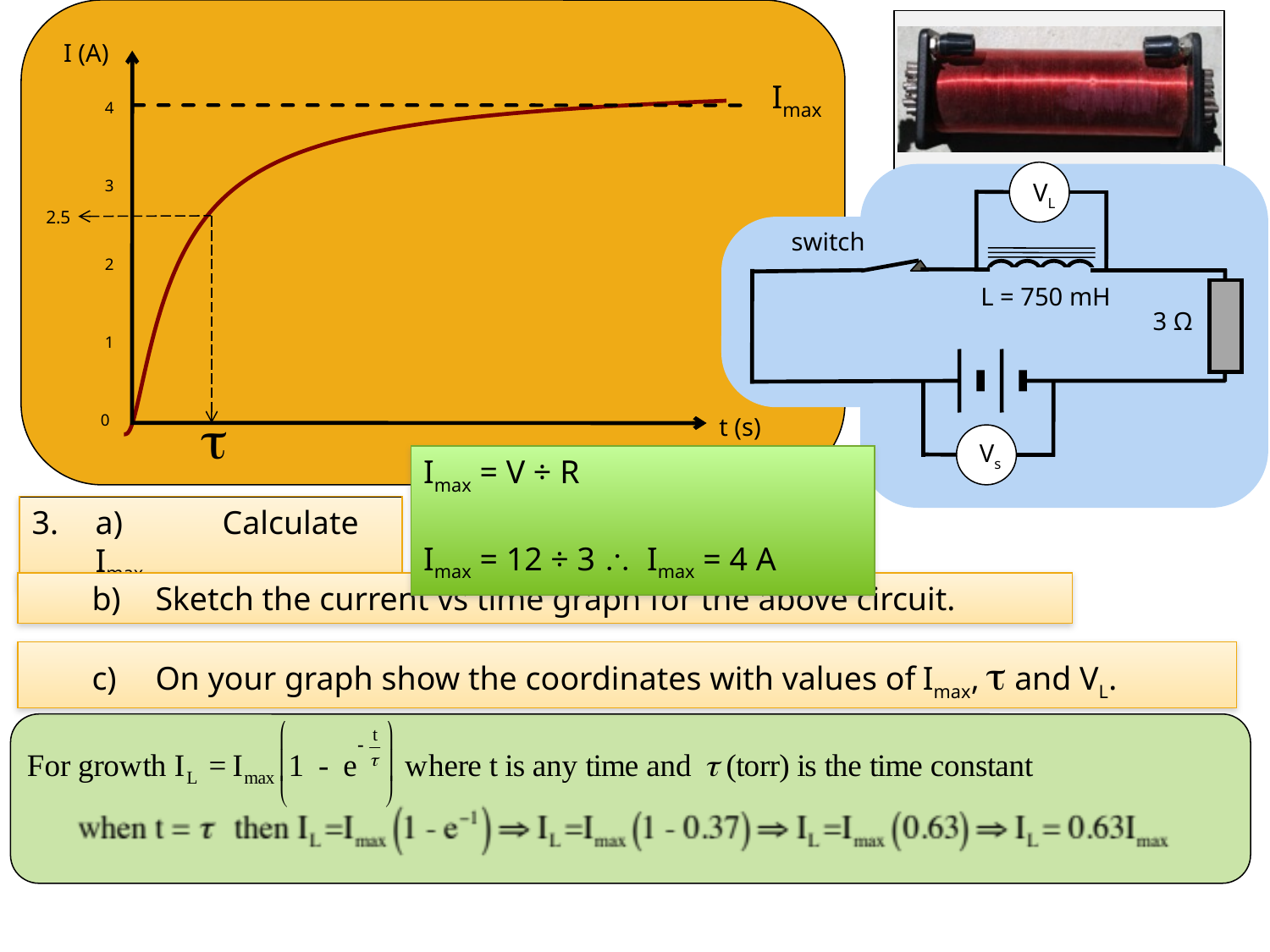
On the current vs time graph, what current value is marked at time τ? 2.5 On the current vs time graph, what current value does the dashed horizontal line labelled Imax sit at? 4 What is the label on the horizontal axis of the current vs time graph? t (s) What kind of chart is shown on the orange panel of the slide? line chart On the current vs time graph, is the current at time τ greater or less than 3? less On the current vs time graph, which is larger: the current at time τ or Imax? Imax On the current vs time graph, is the current at time τ greater or less than 2? greater What is the label on the vertical axis of the current vs time graph? I (A) Does the current on the graph rise or fall as time increases? rise How many curves are plotted on the current vs time graph? 1 What is the highest numbered tick on the vertical axis of the current vs time graph? 4 On the current vs time graph, what is the difference between Imax and the current at time τ? 1.5